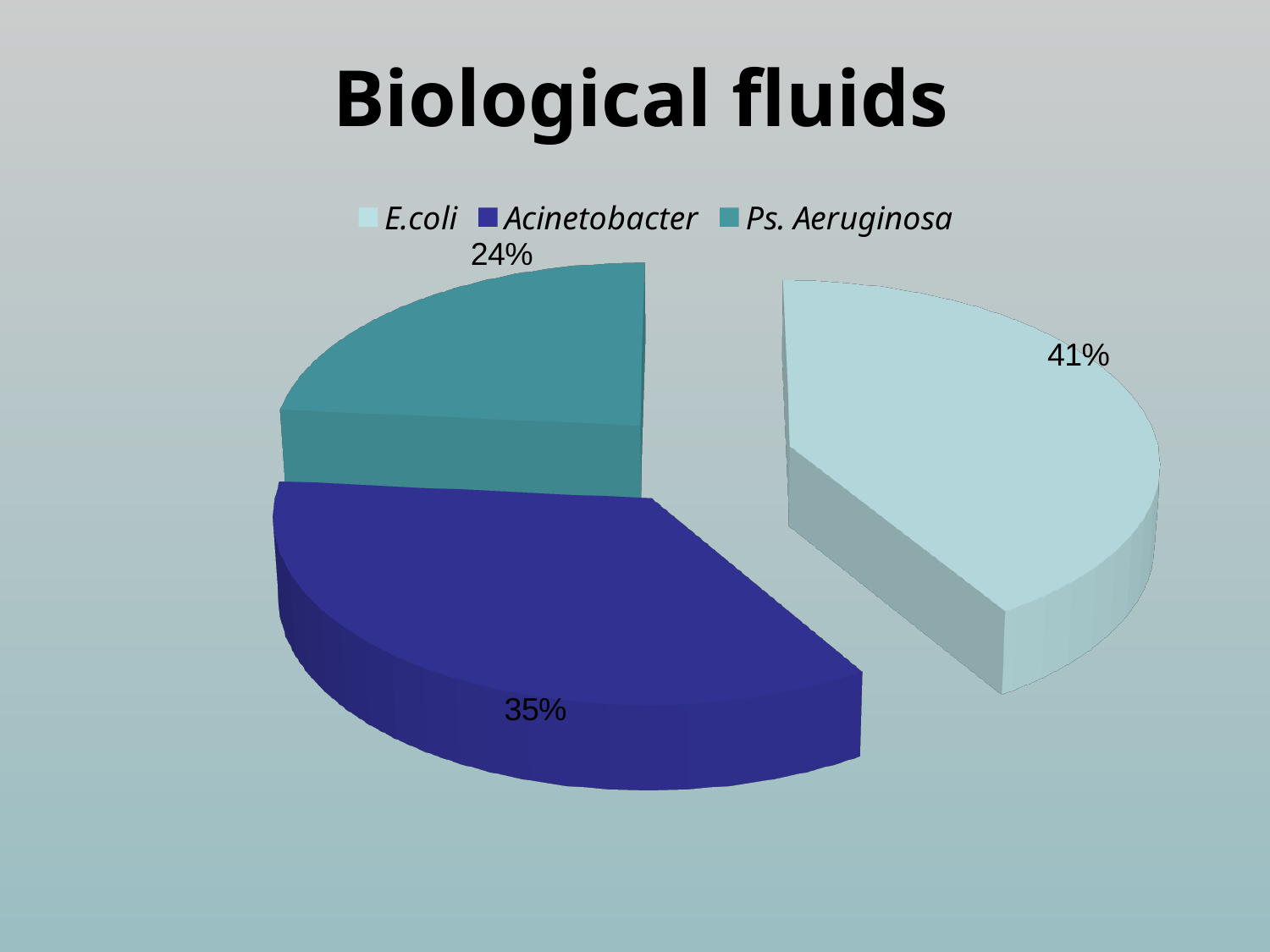
What type of chart is shown on the slide? pie chart How many categories does the pie chart have? 3 Which category is shown in dark blue? Acinetobacter What percentage of the pie is Acinetobacter? 35% Which category has the largest share of the pie? E.coli What is the difference in percentage points between E.coli and Ps. Aeruginosa? 17 Which category has the smallest share of the pie? Ps. Aeruginosa What percentage of the pie is Ps. Aeruginosa? 24% What percentage of the pie is E.coli? 41% What is the title of the chart? Biological fluids Which is larger, the share for Acinetobacter or the share for Ps. Aeruginosa? Acinetobacter What is the difference in percentage points between E.coli and Acinetobacter? 6